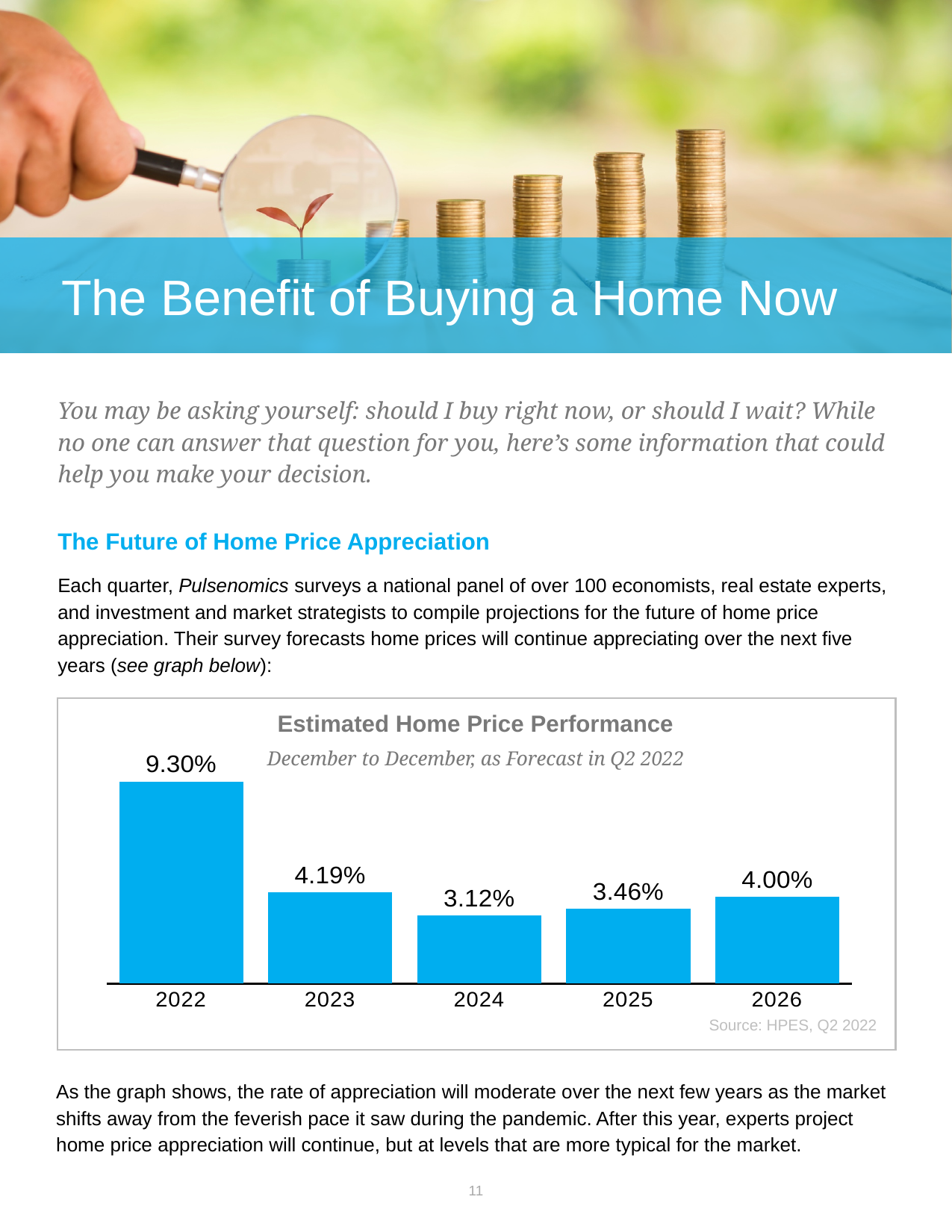
Which year has a higher estimated home price performance, 2023 or 2025? 2023 Which year has the lowest estimated home price performance? 2024 What is the estimated home price performance for 2022? 9.30% What is the difference between the estimated home price performance for 2022 and 2023? 5.11% What is the estimated home price performance for 2024? 3.12% What kind of chart is shown on the slide? Bar chart What is the estimated home price performance for 2026? 4.00% Which year has the highest estimated home price performance? 2022 What is the title of the chart? Estimated Home Price Performance How many years are shown on the chart? 5 Does the estimated home price performance rise or fall from 2022 to 2024? Fall What is the difference between the estimated home price performance for 2026 and 2025? 0.54%